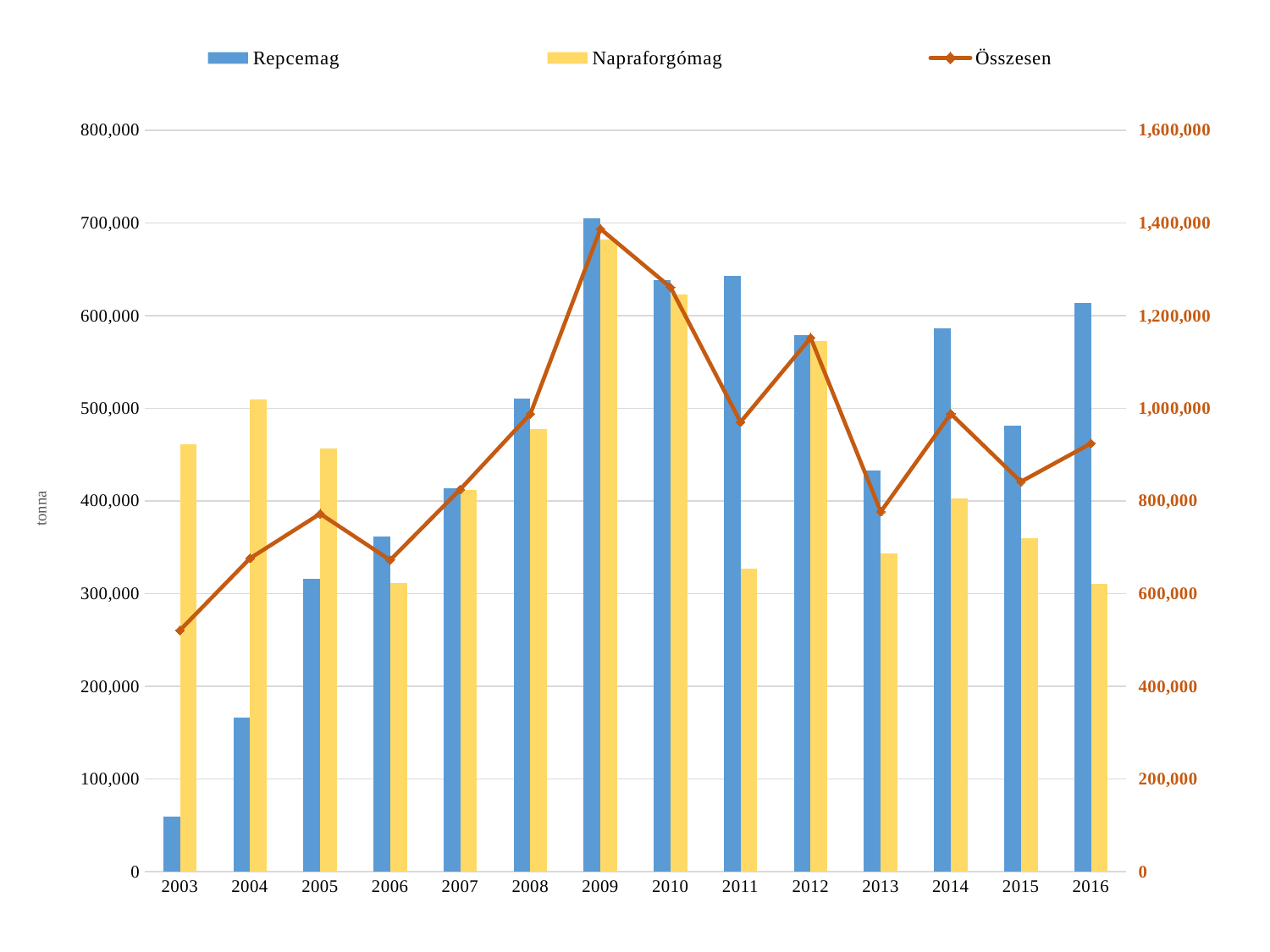
In 2011, which is larger: Repcemag or Napraforgómag? Repcemag In 2003, which is larger: Repcemag or Napraforgómag? Napraforgómag Which year has the lowest Repcemag value? 2003 In which year is the Összesen line at its lowest? 2003 Is the Összesen value for 2009 greater or less than 1,200,000? greater Which year has the highest Repcemag value? 2009 Is the Napraforgómag value for 2004 greater or less than 500,000? greater Which year has the highest Napraforgómag value? 2009 Is the Repcemag value for 2003 greater or less than 100,000? less In which year does the Összesen line reach its highest point? 2009 How many years are shown on the x axis? 14 How many series does the legend list? 3